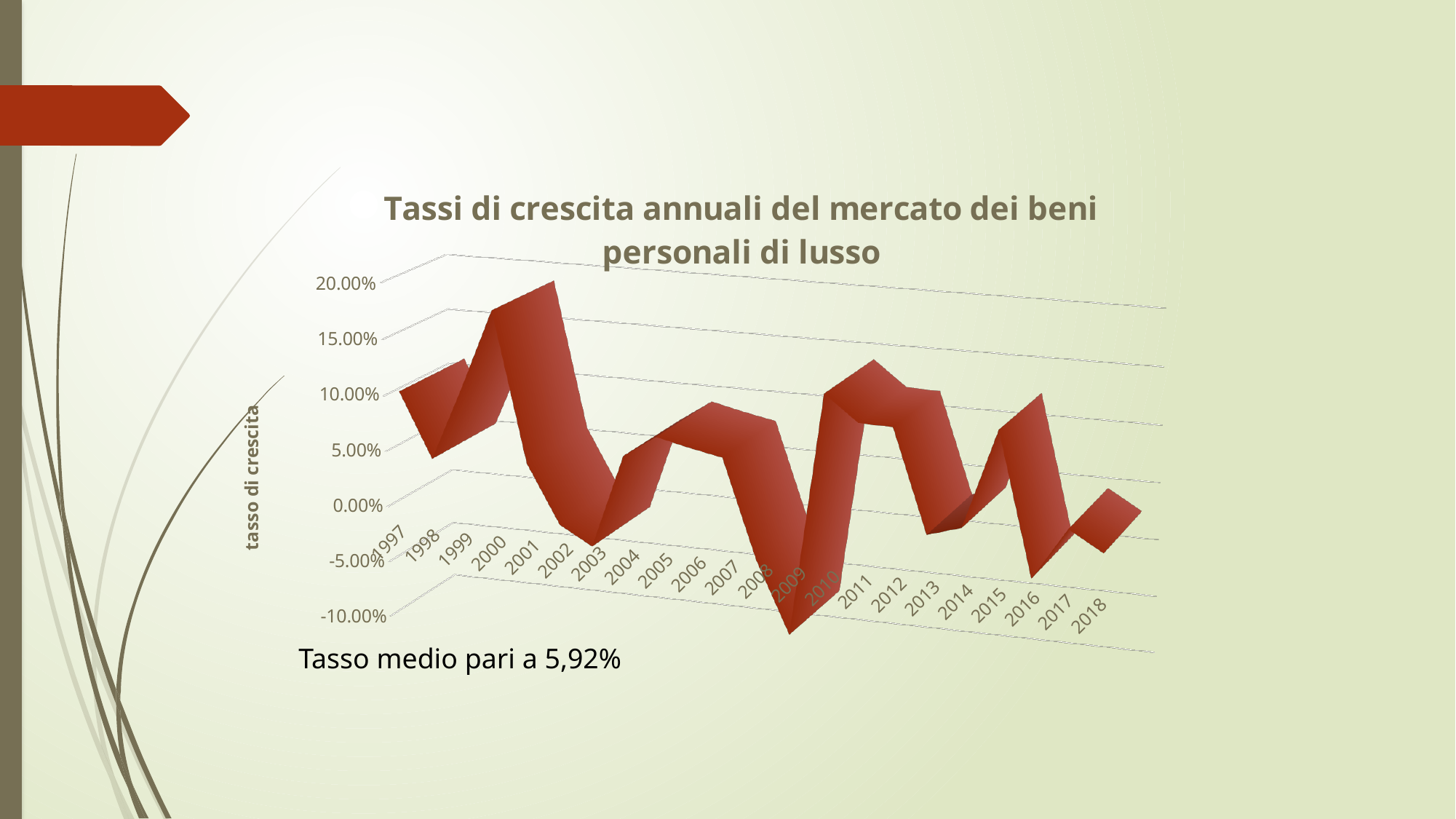
What is the label of the vertical axis? tasso di crescita Which year has the lowest growth rate? 2009 Is the value for 2011 greater or less than 5.00%? greater What is the title of the chart? Tassi di crescita annuali del mercato dei beni personali di lusso Is the value for 2009 greater or less than 0.00%? less Which year has the highest growth rate? 2000 Is the value for 2003 greater or less than 5.00%? less Which year has the larger growth rate, 2011 or 2003? 2011 What kind of chart is shown on the slide? line chart How many years are plotted on the x axis? 22 Which year has the larger growth rate, 2000 or 2009? 2000